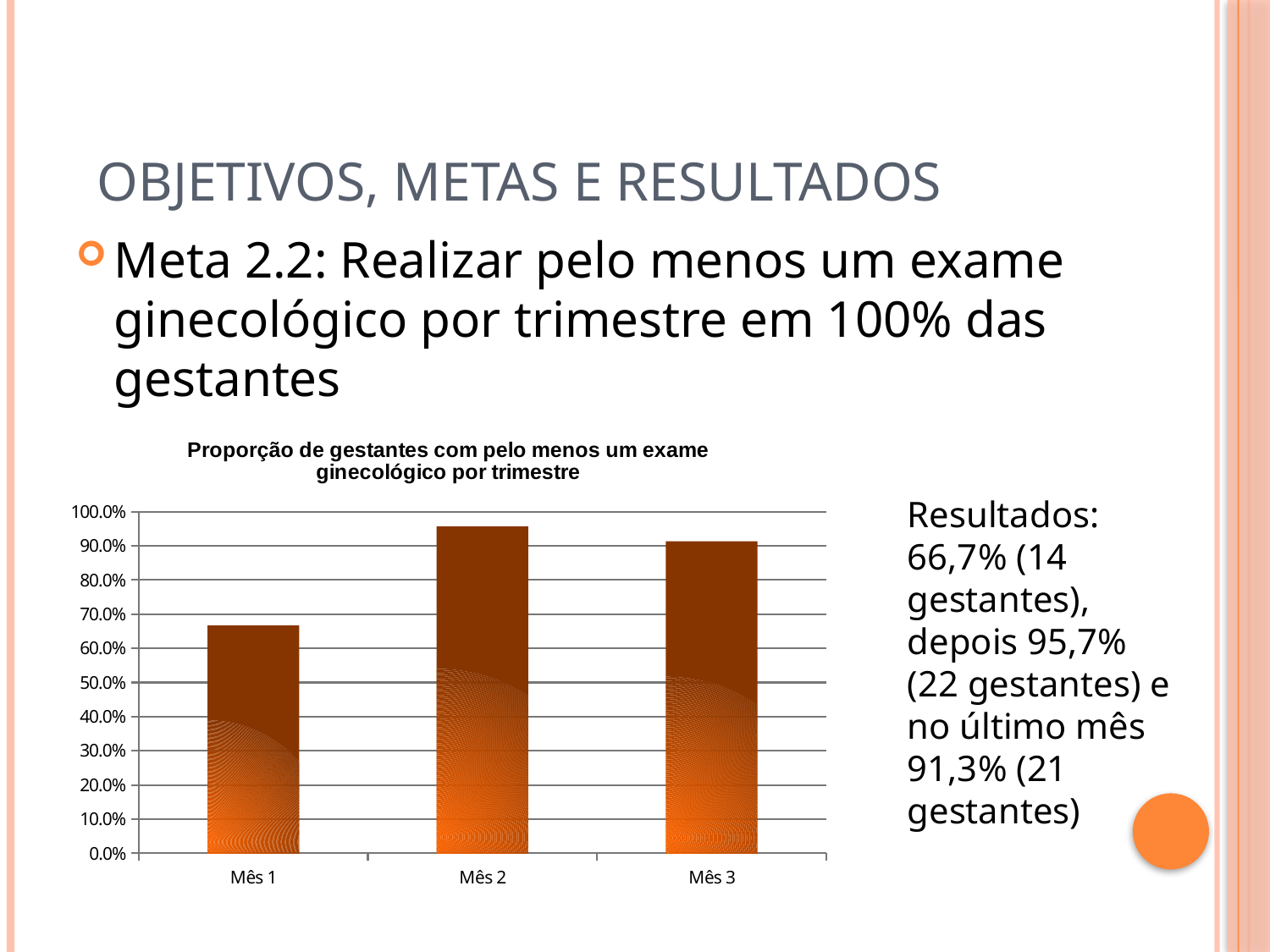
According to the slide, what proportion is reported for Mês 2? 95,7% What is the title of the chart? Proporção de gestantes com pelo menos um exame ginecológico por trimestre Which month has the lowest proportion in the chart? Mês 1 Which is larger, the value for Mês 2 or the value for Mês 3? Mês 2 Does the value rise or fall from Mês 2 to Mês 3? fall What kind of chart is shown on the slide? bar chart How many categories (months) are plotted in the chart? 3 Is the value for Mês 2 greater or less than 90.0%? greater Is the value for Mês 1 greater or less than 70.0%? less Is the value for Mês 3 greater or less than 80.0%? greater According to the slide, what proportion of pregnant women had at least one gynecological exam in Mês 1? 66,7% Which month has the highest proportion in the chart? Mês 2